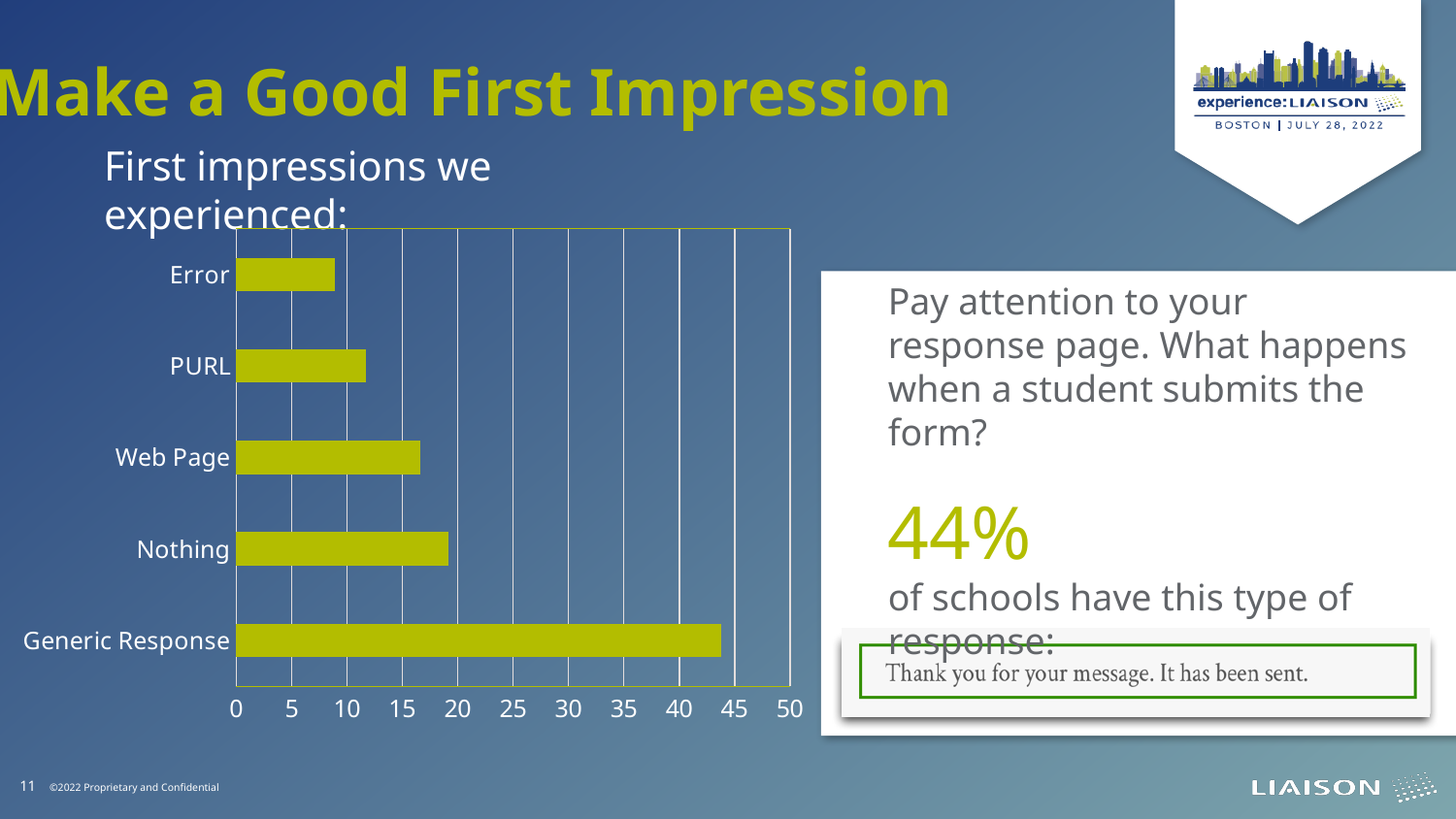
Is the value for PURL greater or less than 10? greater Is the value for Web Page greater or less than 15? greater Which has a larger value, PURL or Error? PURL What is the title of the chart? First impressions we experienced: Is the value for Error greater or less than 15? less How many categories are shown in the bar chart? 5 Which category has the lowest value in the bar chart? Error Which has a larger value, Generic Response or Nothing? Generic Response What kind of chart is shown on the slide? bar chart Which category has the highest value in the bar chart? Generic Response